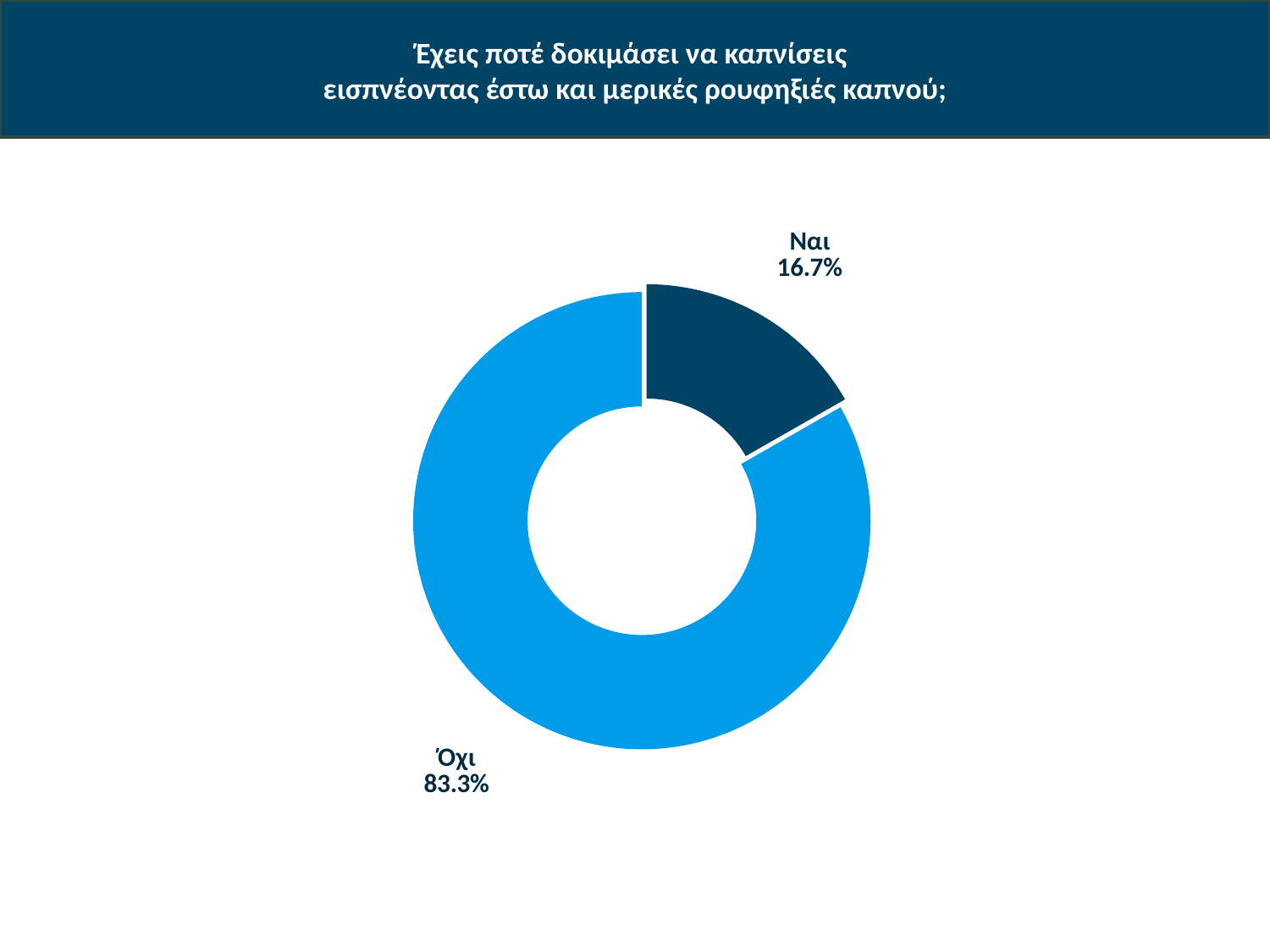
Which category has the largest share of the chart? Όχι How many categories are shown in the chart? 2 What percentage of respondents answered "Ναι"? 16.7% What percentage of respondents answered "Όχι"? 83.3% What kind of chart is shown on the slide? Doughnut (pie) chart What is the difference in percentage points between "Όχι" and "Ναι"? 66.6 What is the total of the two slices shown? 100% What share of the chart does the "Ναι" slice represent? 16.7% Which category has the smallest share of the chart? Ναι What question is shown as the title of the slide? Έχεις ποτέ δοκιμάσει να καπνίσεις εισπνέοντας έστω και μερικές ρουφηξιές καπνού; What colour is the "Ναι" slice? Dark blue Which is larger, the share for "Ναι" or the share for "Όχι"? Όχι